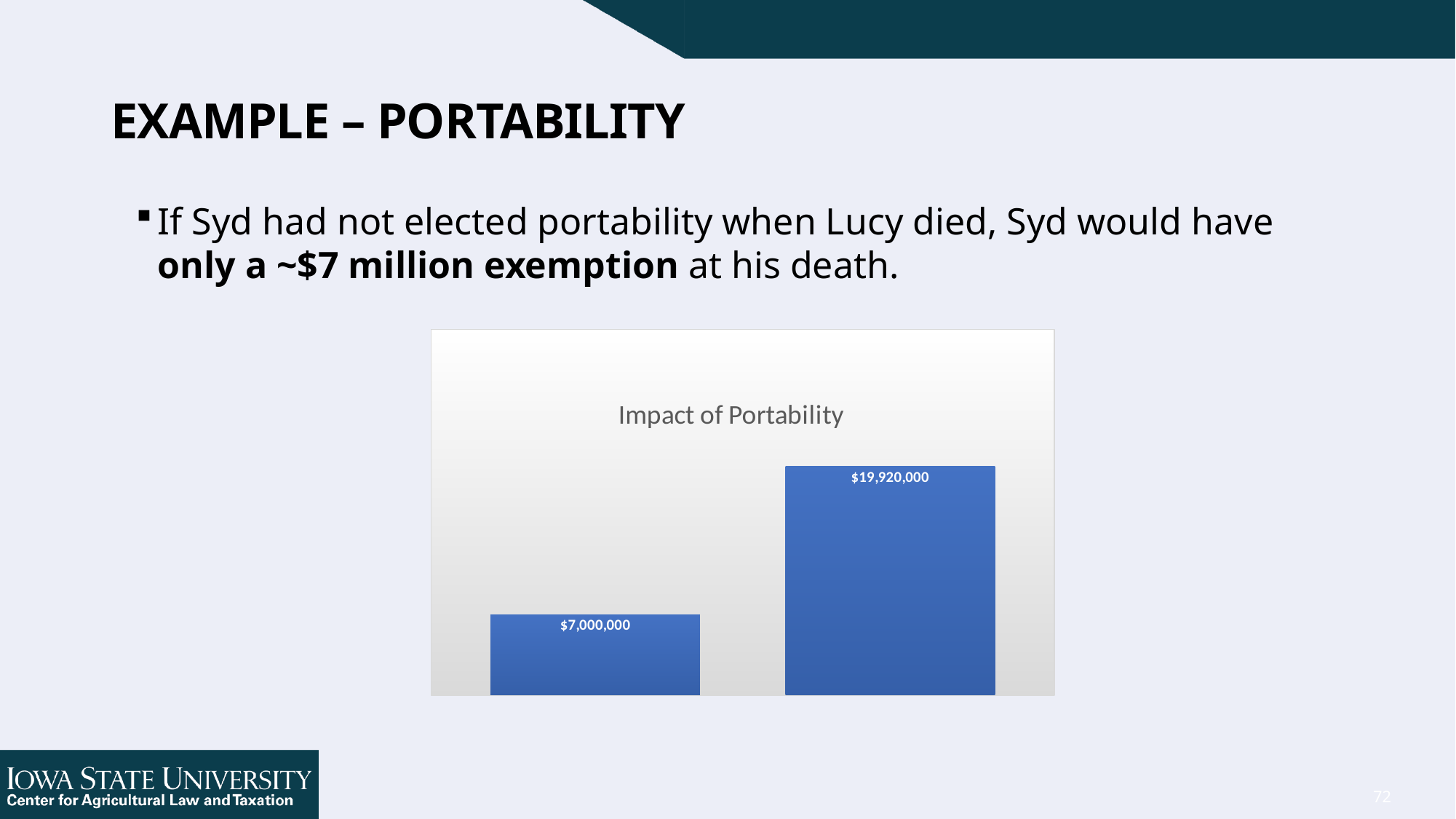
What value is labelled on the right bar of the Impact of Portability chart? $19,920,000 In the Impact of Portability chart, is the left bar's value larger or smaller than the right bar's value? smaller What colour are the bars in the Impact of Portability chart? blue Which bar in the Impact of Portability chart is the tallest, the left or the right? right What is the title of the chart on the slide? Impact of Portability What is the smallest value labelled in the Impact of Portability chart? $7,000,000 Which bar in the Impact of Portability chart is the shortest, the left or the right? left What is the difference between the two values shown in the Impact of Portability chart? $12,920,000 What type of chart is shown on the slide? bar chart How many bars are plotted in the Impact of Portability chart? 2 What is the largest value labelled in the Impact of Portability chart? $19,920,000 What value is labelled on the left bar of the Impact of Portability chart? $7,000,000